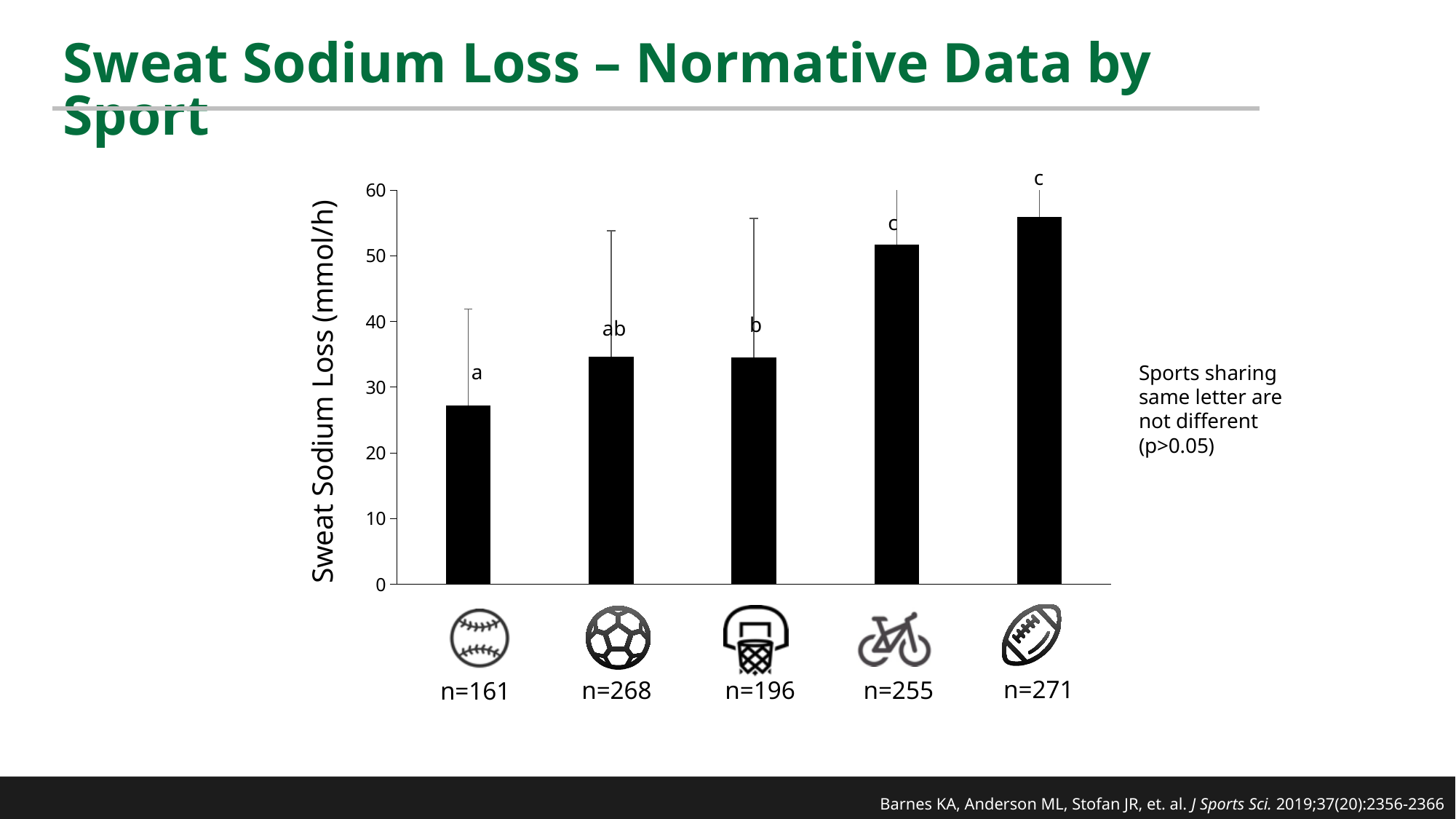
Which sport has the highest sweat sodium loss in the chart? American football (n=271) Is the sweat sodium loss for the baseball group (n=161) greater or less than 30 mmol/h? less Is the sweat sodium loss for the cycling group (n=255) greater or less than 40 mmol/h? greater Which has a higher sweat sodium loss: the cycling group (n=255) or the basketball group (n=196)? Cycling (n=255) Do the bar values generally rise or fall from left to right across the sports? rise What is the label on the y-axis of the chart? Sweat Sodium Loss (mmol/h) How many sports (bars) are plotted in the chart? 5 Is the sweat sodium loss for the American football group (n=271) greater or less than 50 mmol/h? greater Which sport has the lowest sweat sodium loss in the chart? Baseball (n=161) What kind of chart is shown on the slide? bar chart What is the sample size (n) shown for the basketball group? n=196